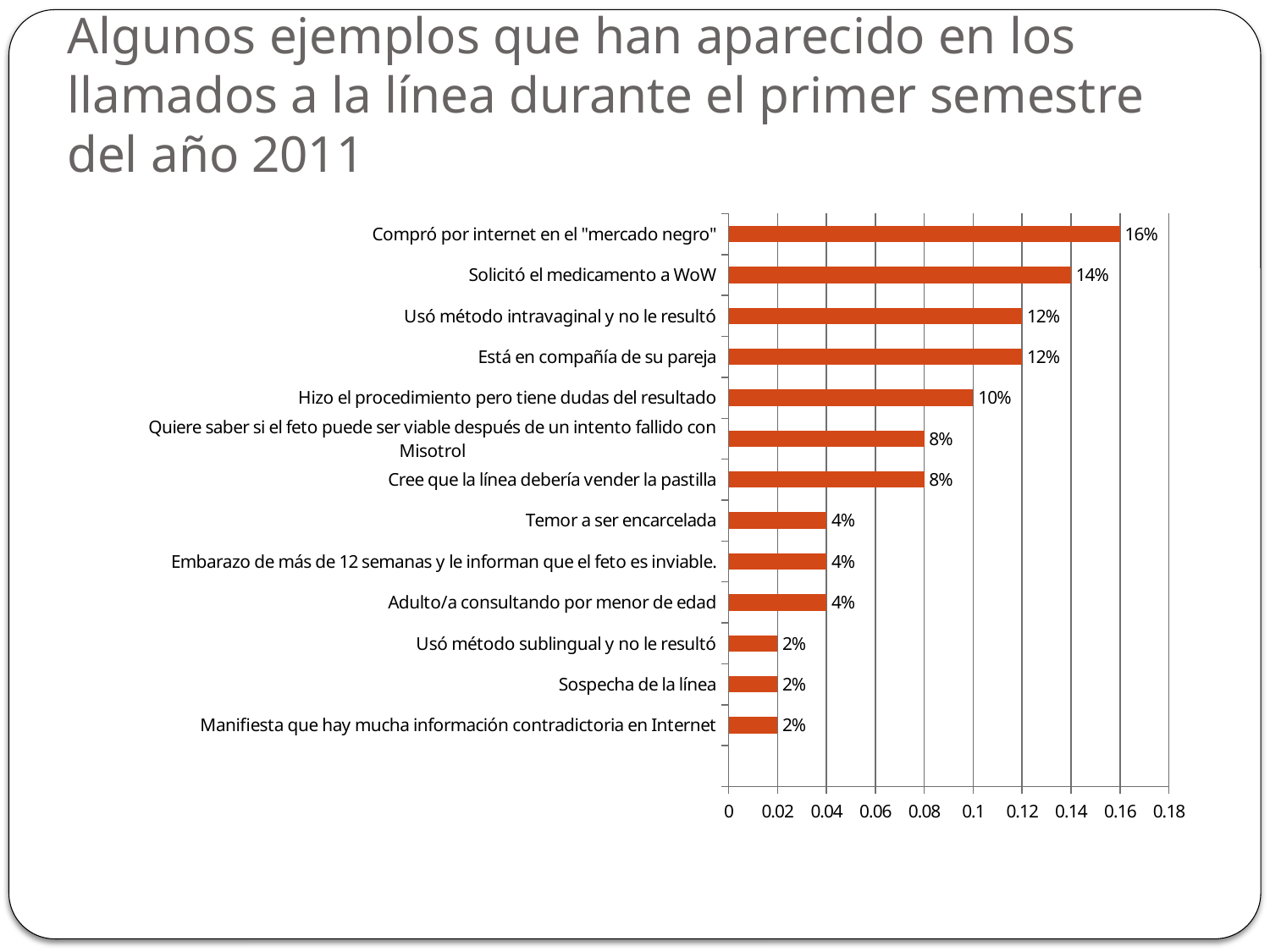
What is the value for "Temor a ser encarcelada"? 4% What is the value for "Hizo el procedimiento pero tiene dudas del resultado"? 10% What is the value for "Cree que la línea debería vender la pastilla"? 8% Which category has the highest value? Compró por internet en el "mercado negro" What kind of chart is shown on the slide? bar chart What is the difference between the values for "Compró por internet en el "mercado negro"" and "Solicitó el medicamento a WoW"? 2% How many categories are plotted in the chart? 13 Is the value for "Está en compañía de su pareja" greater or less than 0.1? greater What is the difference between the values for "Hizo el procedimiento pero tiene dudas del resultado" and "Sospecha de la línea"? 8% What is the value for "Solicitó el medicamento a WoW"? 14% What colour are the bars in the chart? orange-red Which is larger: the value for "Usó método intravaginal y no le resultó" or the value for "Usó método sublingual y no le resultó"? Usó método intravaginal y no le resultó